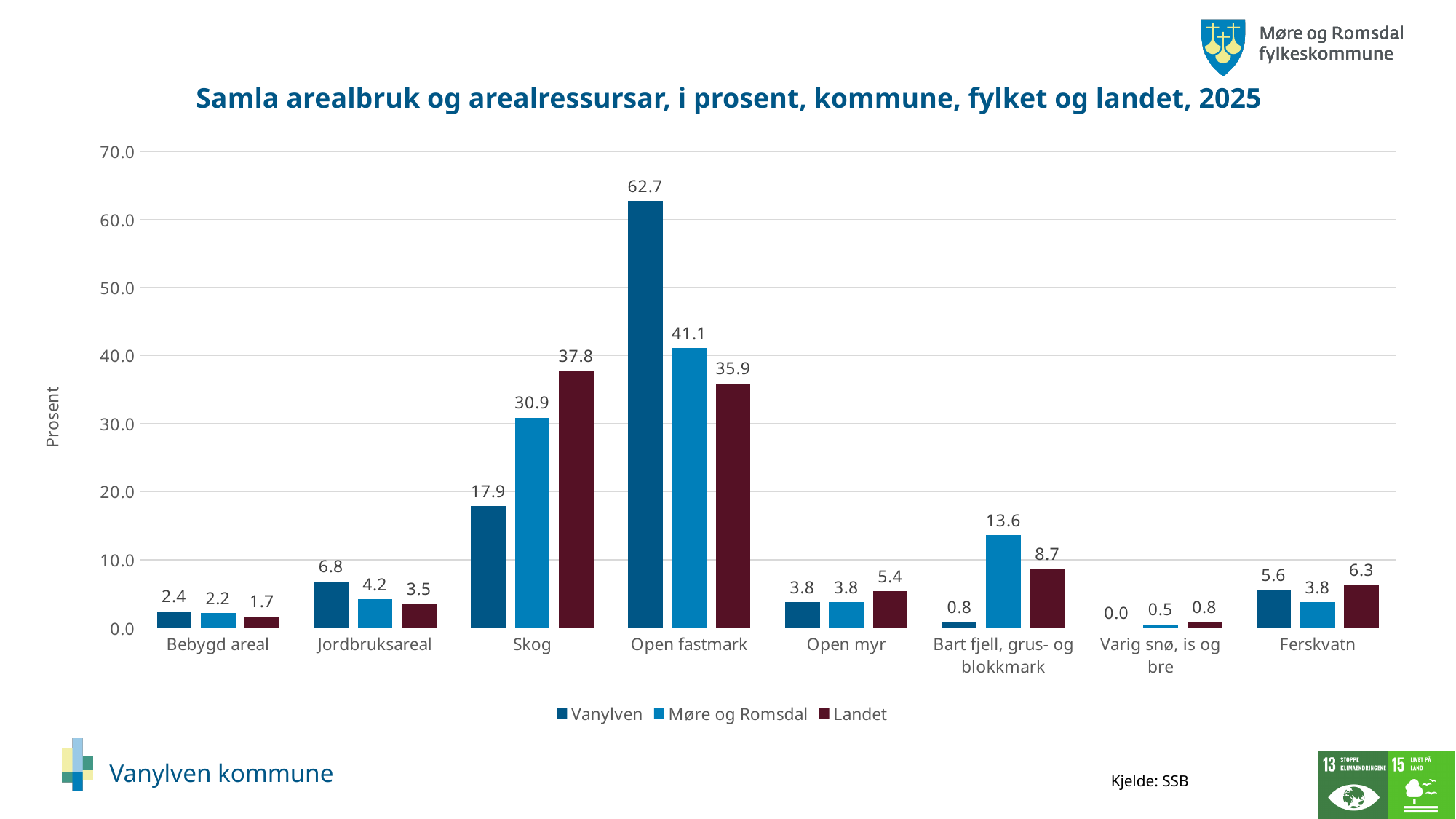
What is the label on the y axis? Prosent Which category has the lowest value for Vanylven? Varig snø, is og bre How many categories are shown on the x axis? 8 What kind of chart is shown on the slide? Bar chart What is the title of the chart? Samla arealbruk og arealressursar, i prosent, kommune, fylket og landet, 2025 What is the difference between the Vanylven and Møre og Romsdal values for Open fastmark? 21.6 How many series does the legend list? 3 What is the value for Møre og Romsdal in the Bart fjell, grus- og blokkmark category? 13.6 Which is larger in the Skog category: the value for Vanylven or the value for Landet? Landet Which category has the highest value for Vanylven? Open fastmark What is the value for Vanylven in the Open fastmark category? 62.7 What is the value for Landet in the Skog category? 37.8